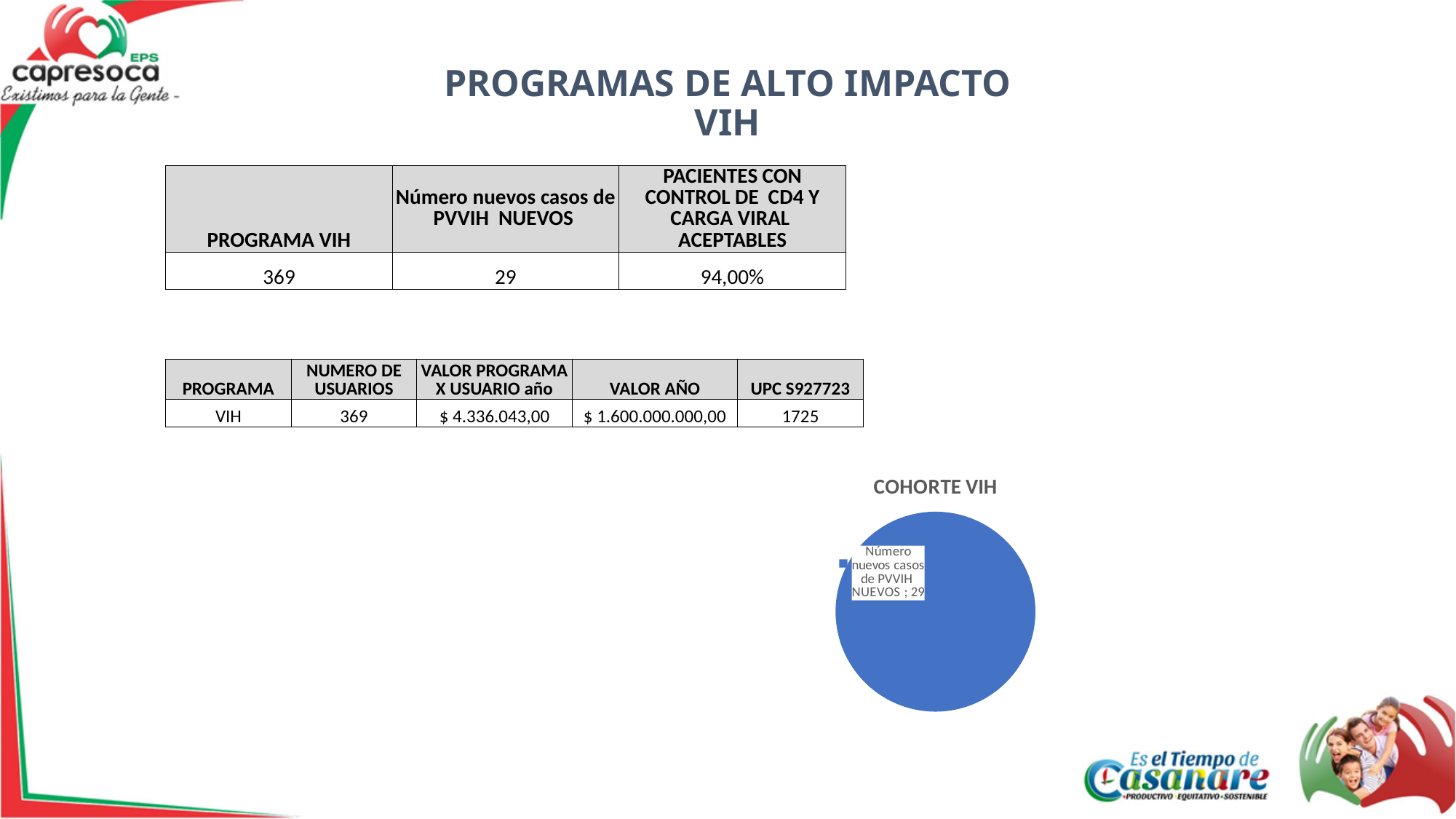
What colour is the slice in the COHORTE VIH pie chart? blue How many slices does the COHORTE VIH pie chart contain? 1 In the COHORTE VIH pie chart, what value is shown for Número nuevos casos de PVVIH NUEVOS? 29 What is the title of the chart on the slide? COHORTE VIH What kind of chart is shown under the title COHORTE VIH? pie chart Is the value for Número nuevos casos de PVVIH NUEVOS in the COHORTE VIH chart greater or less than 20? greater